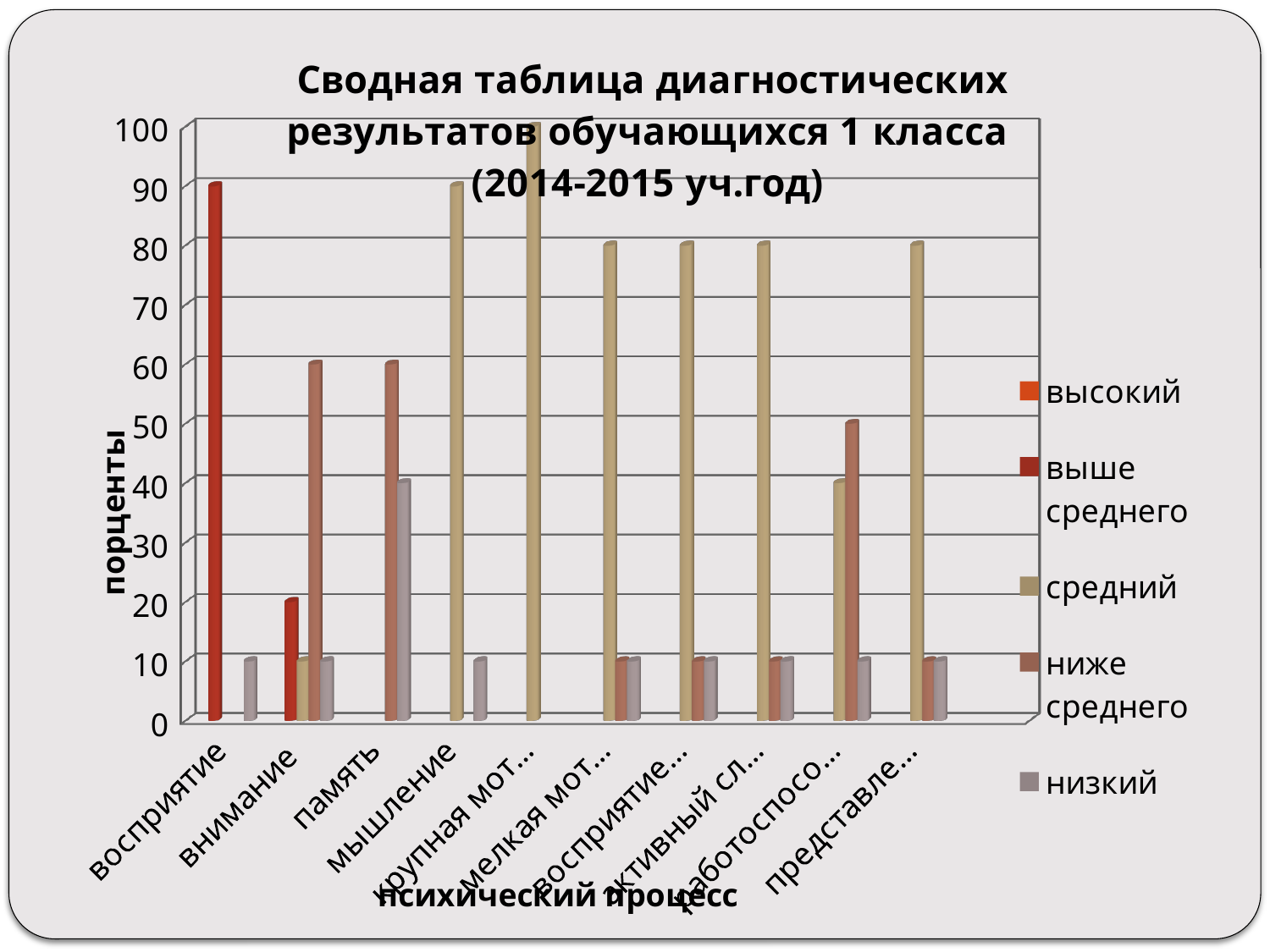
How many categories are shown along the x axis? 10 What is the value of the 'ниже среднего' series for 'внимание'? 60 For 'память', what is the difference between the 'ниже среднего' value and the 'низкий' value? 20 What is the value of the 'выше среднего' series for 'восприятие'? 90 Is the 'выше среднего' value for 'восприятие' greater or less than 50? greater What is the title of the vertical axis? порценты What is the value of the 'низкий' series for 'память'? 40 For the category 'внимание', which series has the highest value? ниже среднего What is the value of the 'средний' series for 'мышление'? 90 What kind of chart is shown on the slide? bar chart How many series does the legend list? 5 For 'память', which is larger: the 'ниже среднего' value or the 'низкий' value? ниже среднего